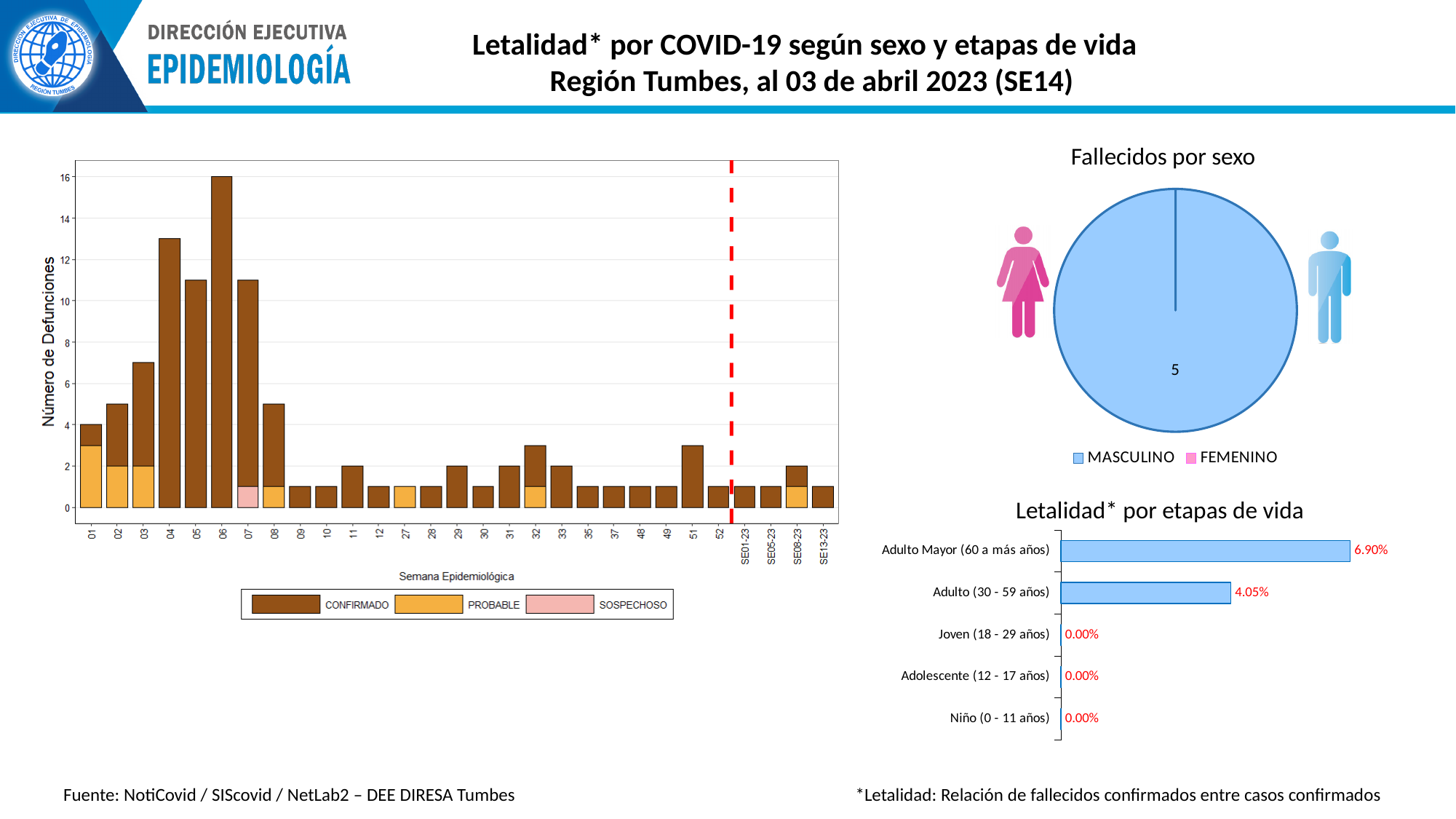
In the left chart of deaths by epidemiological week, what is the total number of deaths in week 06? 16 In the 'Letalidad* por etapas de vida' chart, what is the value for Joven (18 - 29 años)? 0.00% In the left chart of deaths by epidemiological week, which week has the highest number of deaths? 06 In the left chart of deaths by epidemiological week, is the total for week 04 greater or less than 12? greater In the 'Fallecidos por sexo' pie chart, how many entries does the legend list? 2 In the 'Letalidad* por etapas de vida' chart, what is the value for Adulto (30 - 59 años)? 4.05% In the 'Letalidad* por etapas de vida' chart, what is the difference between the values for Adulto Mayor (60 a más años) and Adulto (30 - 59 años)? 2.85% In the 'Letalidad* por etapas de vida' chart, how many age groups are shown? 5 In the 'Fallecidos por sexo' pie chart, what value is printed on the MASCULINO slice? 5 In the left chart of deaths by epidemiological week, how many series does the legend list? 3 In the 'Letalidad* por etapas de vida' chart, what is the value for Adulto Mayor (60 a más años)? 6.90% In the 'Letalidad* por etapas de vida' chart, which age group has the highest value? Adulto Mayor (60 a más años)